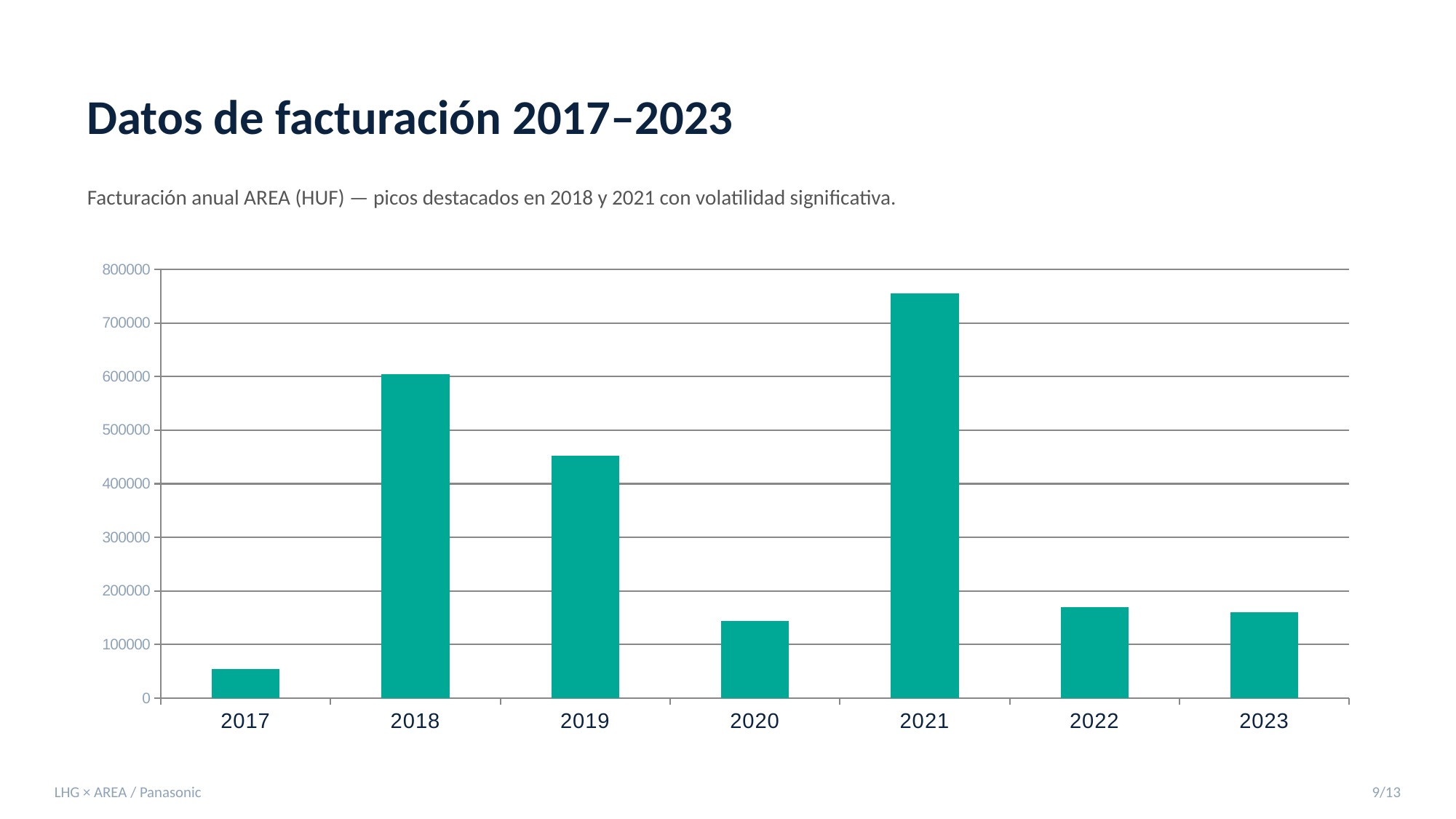
Is the value for 2022 greater or less than 200000? less What is the title of the slide containing the chart? Datos de facturación 2017–2023 Which is larger, the value for 2020 or the value for 2021? 2021 Which year has the lowest value? 2017 Which is larger, the value for 2018 or the value for 2019? 2018 Which year has the highest value? 2021 What kind of chart is shown on the slide? bar chart Is the value for 2021 greater or less than 700000? greater How many years are plotted on the chart? 7 Is the value for 2019 greater or less than 500000? less